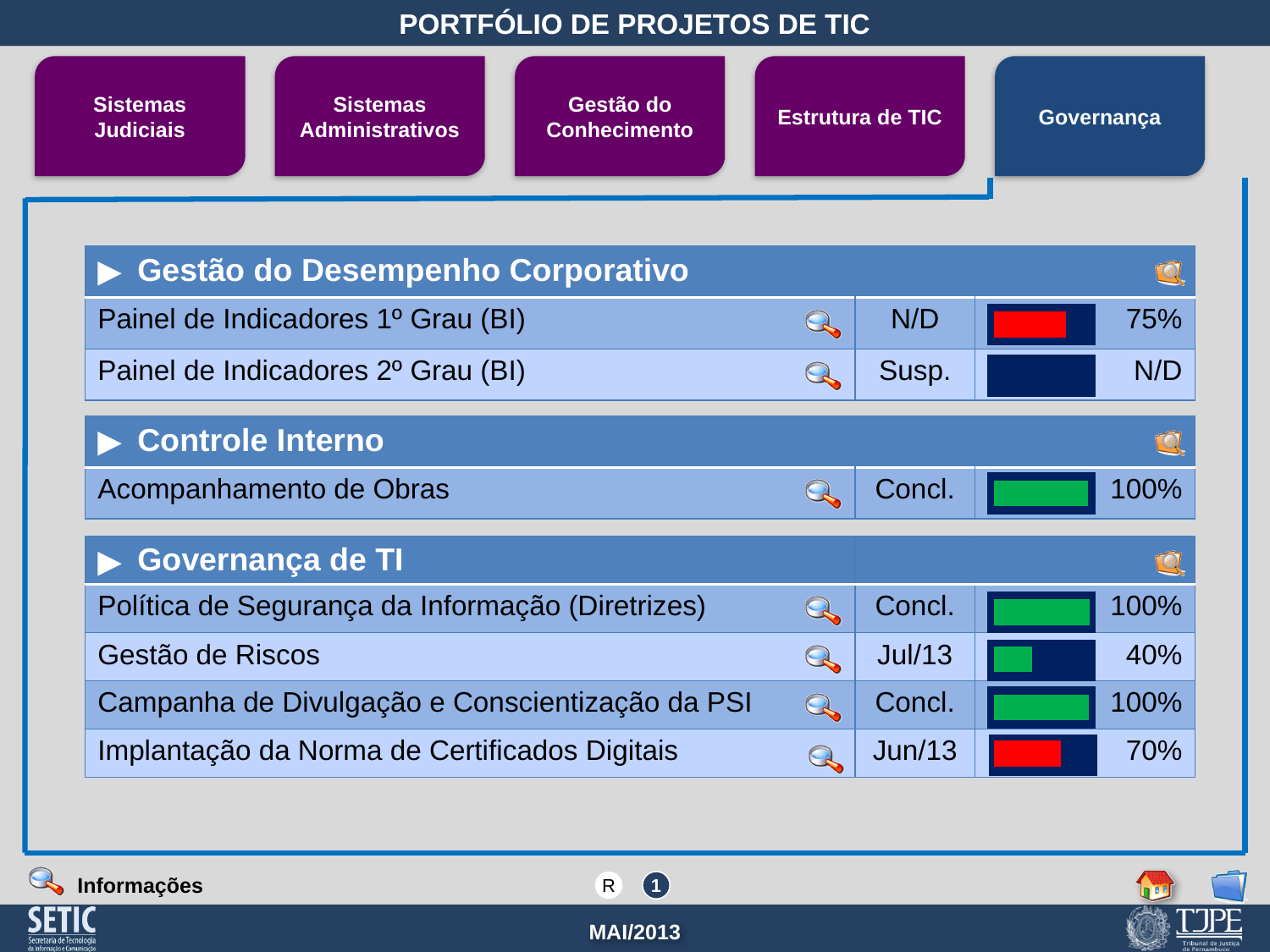
What completion percentage is shown for Acompanhamento de Obras? 100% What is shown in the percentage column for Painel de Indicadores 2º Grau (BI)? N/D What completion percentage is shown for Painel de Indicadores 1º Grau (BI)? 75% What completion percentage is shown for Implantação da Norma de Certificados Digitais? 70% What is the difference in completion percentage between Painel de Indicadores 1º Grau (BI) and Gestão de Riscos? 35 percentage points How many projects on the slide show a completion of 100%? 3 How many projects are listed under Governança de TI? 4 Which has a higher completion percentage, Painel de Indicadores 1º Grau (BI) or Implantação da Norma de Certificados Digitais? Painel de Indicadores 1º Grau (BI) What completion percentage is shown for Gestão de Riscos? 40% Which project has the lowest completion percentage among those with a percentage shown? Gestão de Riscos What colour is the progress bar for Gestão de Riscos? Green What is the difference in completion percentage between Campanha de Divulgação e Conscientização da PSI and Implantação da Norma de Certificados Digitais? 30 percentage points